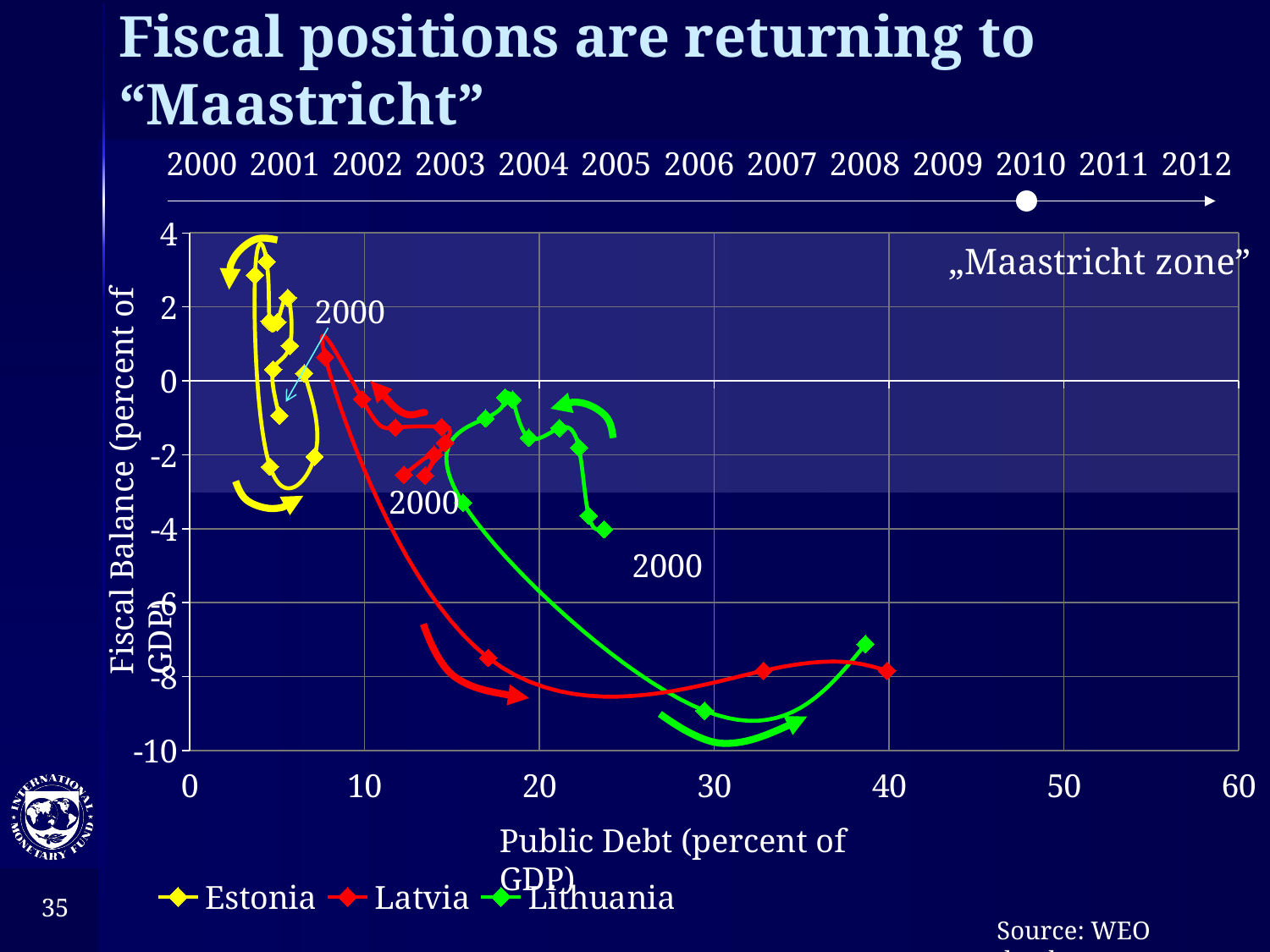
What is the label of the horizontal axis? Public Debt (percent of GDP) Which country's series stays at the lowest public debt levels on the chart? Estonia Is the highest fiscal balance reached by Estonia greater or less than 2? greater Which countries are listed in the chart legend? Estonia, Latvia, Lithuania How many series does the legend list? 3 Which country's series reaches the highest fiscal balance on the chart? Estonia Are all of Estonia's public debt values greater or less than 10 percent of GDP? less Is the fiscal balance of Latvia's point at about 40 percent public debt greater or less than -6? less Which has a higher maximum public debt on the chart, Estonia or Lithuania? Lithuania What is the highest value shown on the horizontal (Public Debt) axis? 60 What kind of chart is shown on the slide? scatter chart